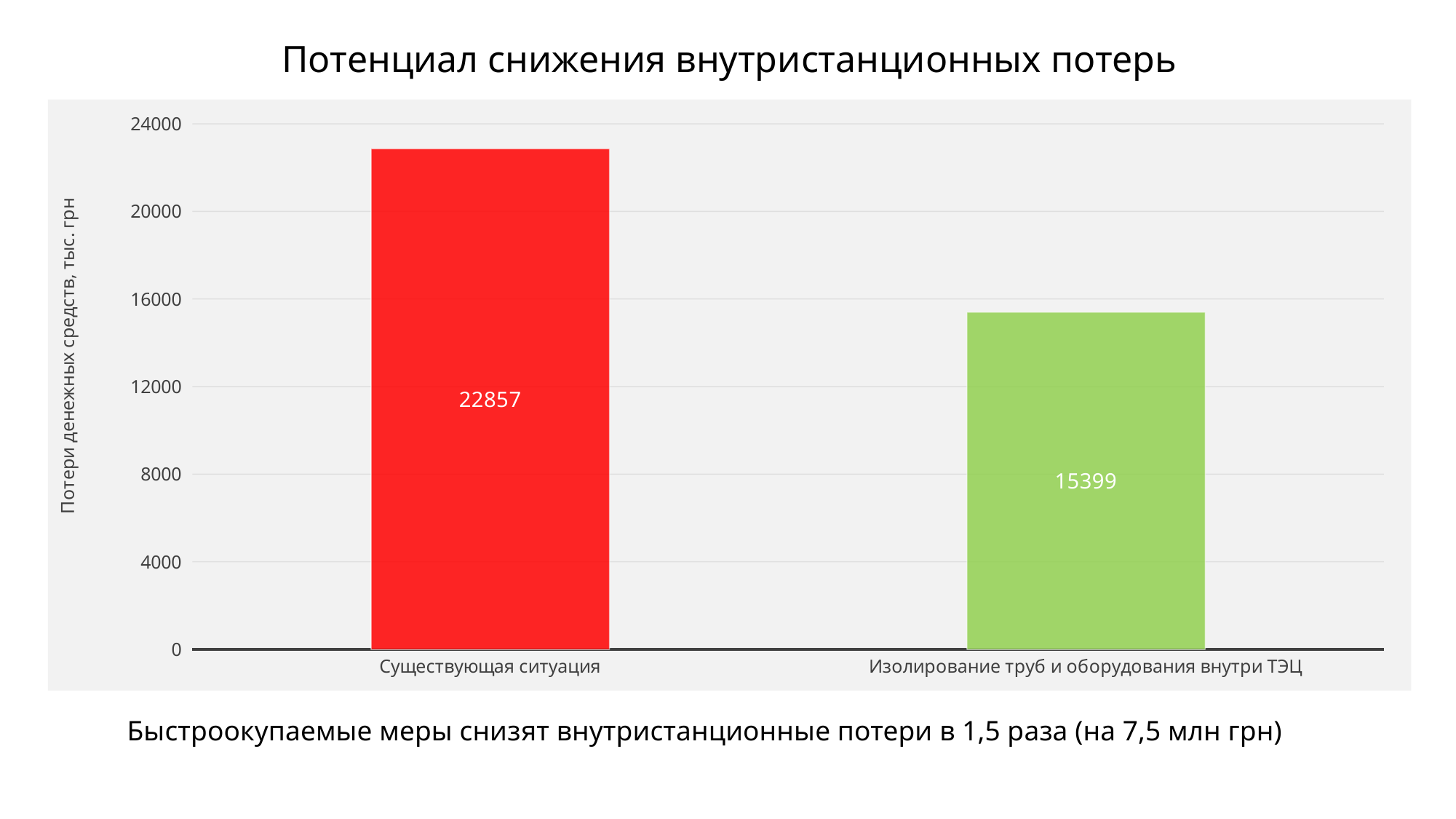
What is the title of the chart? Потенциал снижения внутристанционных потерь How many categories are shown on the chart? 2 What is the value for Существующая ситуация? 22857 What is the difference between the values for Существующая ситуация and Изолирование труб и оборудования внутри ТЭЦ? 7458 Is the value for Существующая ситуация greater or less than 20000? greater What kind of chart is shown on the slide? bar chart Which is larger: the value for Существующая ситуация or for Изолирование труб и оборудования внутри ТЭЦ? Существующая ситуация What is the value for Изолирование труб и оборудования внутри ТЭЦ? 15399 Which category has the highest value? Существующая ситуация Is the value for Изолирование труб и оборудования внутри ТЭЦ greater or less than 16000? less Which category has the lowest value? Изолирование труб и оборудования внутри ТЭЦ What is the label of the vertical axis? Потери денежных средств, тыс. грн